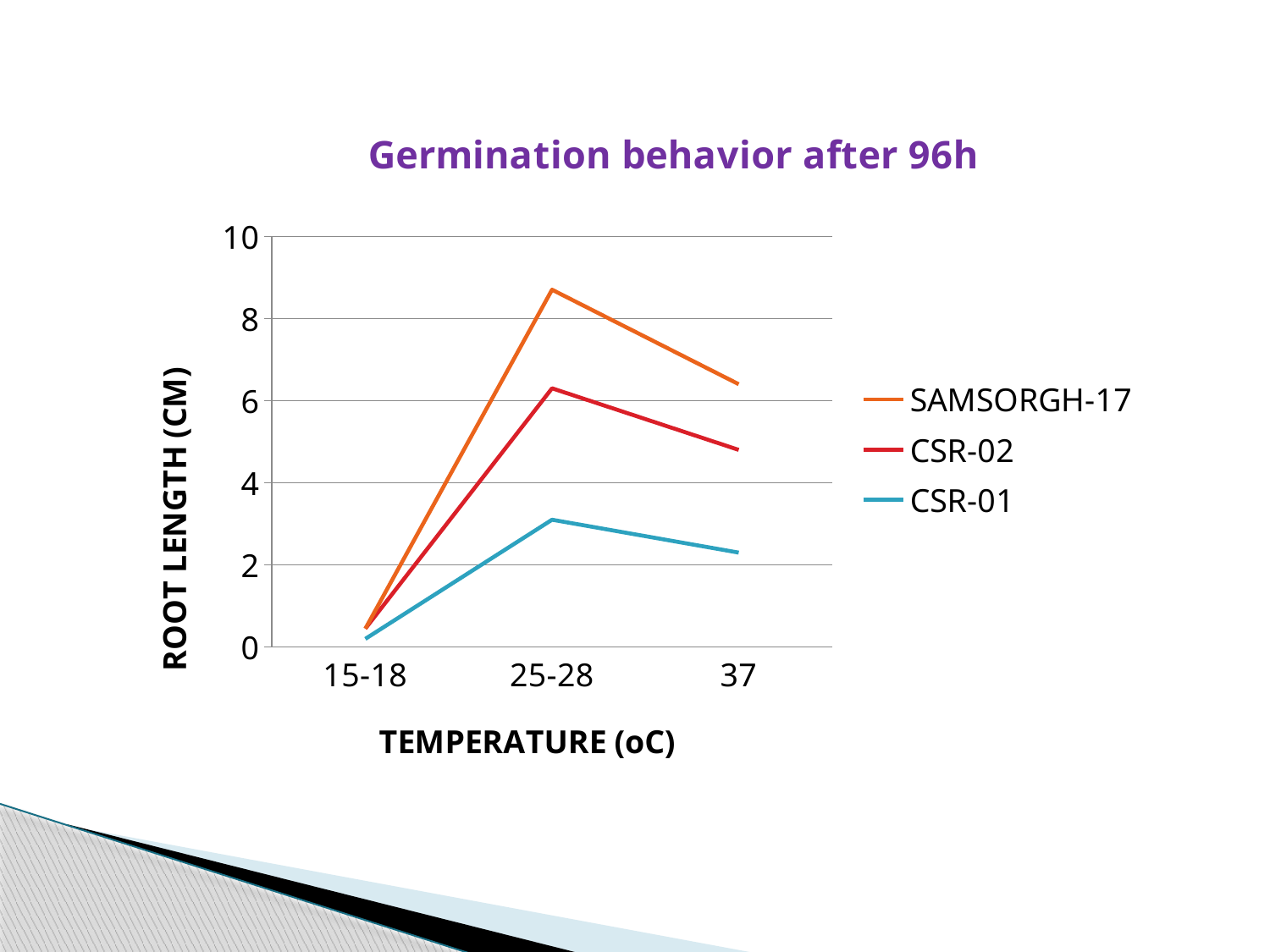
Which series has the highest root length at 25-28? SAMSORGH-17 How many temperature categories are shown on the x axis? 3 At 25-28, which series has the larger root length, CSR-02 or CSR-01? CSR-02 Which series has the lowest root length at 37? CSR-01 Is the root length for CSR-01 at 25-28 greater or less than 4? less Is the root length for SAMSORGH-17 at 25-28 greater or less than 8? greater What kind of chart is shown on the slide? line chart At which temperature does SAMSORGH-17 reach its highest root length? 25-28 What is the title of the chart? Germination behavior after 96h Is the root length for CSR-02 at 37 greater or less than 4? greater Does the root length for CSR-01 rise or fall from 25-28 to 37? fall How many series does the legend list? 3